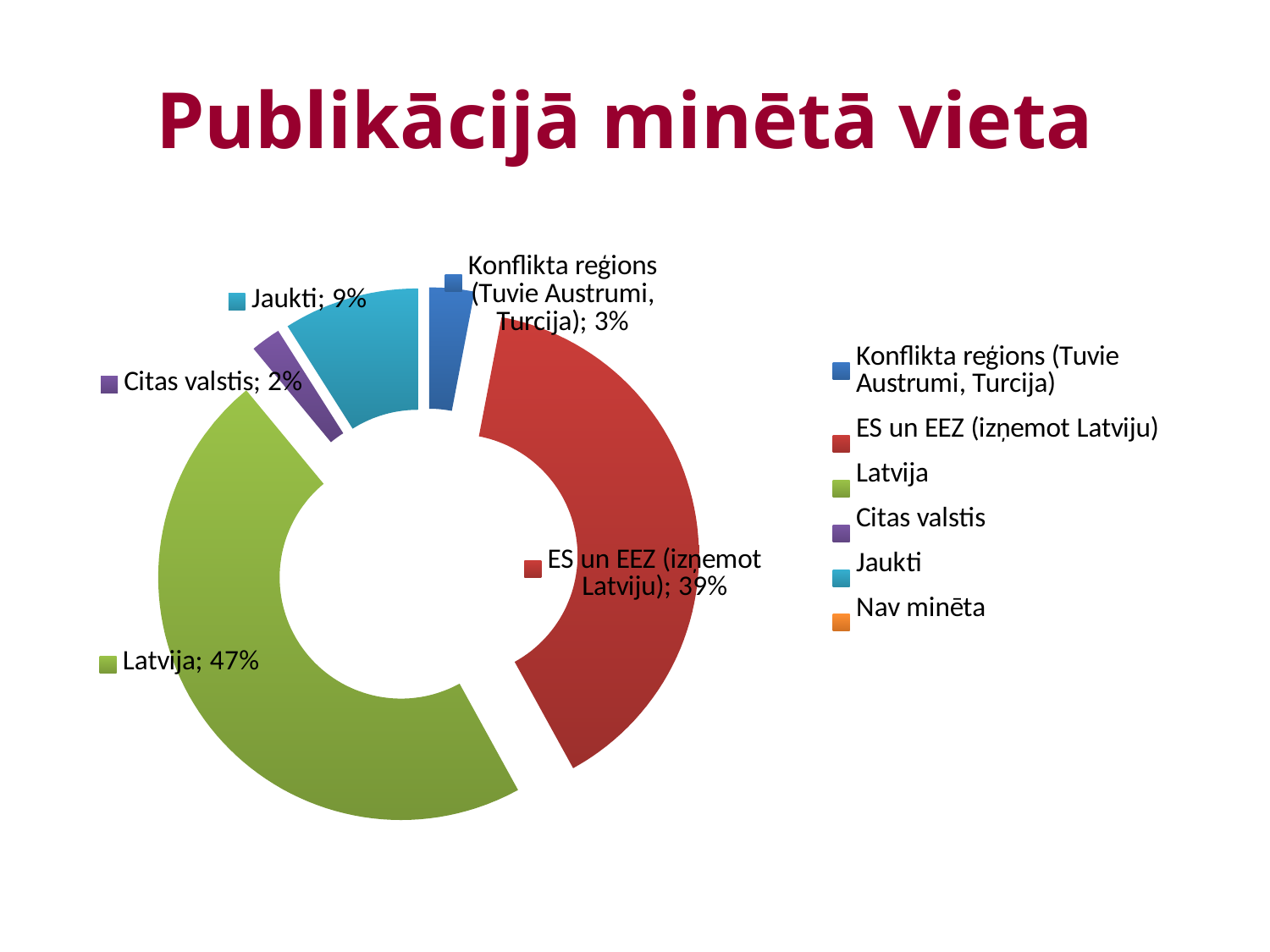
What percentage is shown for Jaukti? 9% How many entries does the legend list? 6 Which labelled category has the smallest share of the chart? Citas valstis What percentage is shown for Citas valstis? 2% Which category has the largest share of the chart? Latvija What percentage is shown for Latvija? 47% What kind of chart is shown on the slide? Doughnut (pie) chart What is the title of the slide? Publikācijā minētā vieta What percentage is shown for ES un EEZ (izņemot Latviju)? 39% What is the difference in percentage points between Latvija and ES un EEZ (izņemot Latviju)? 8 What percentage is shown for Konflikta reģions (Tuvie Austrumi, Turcija)? 3% Which is larger, the share for Jaukti or the share for Konflikta reģions (Tuvie Austrumi, Turcija)? Jaukti